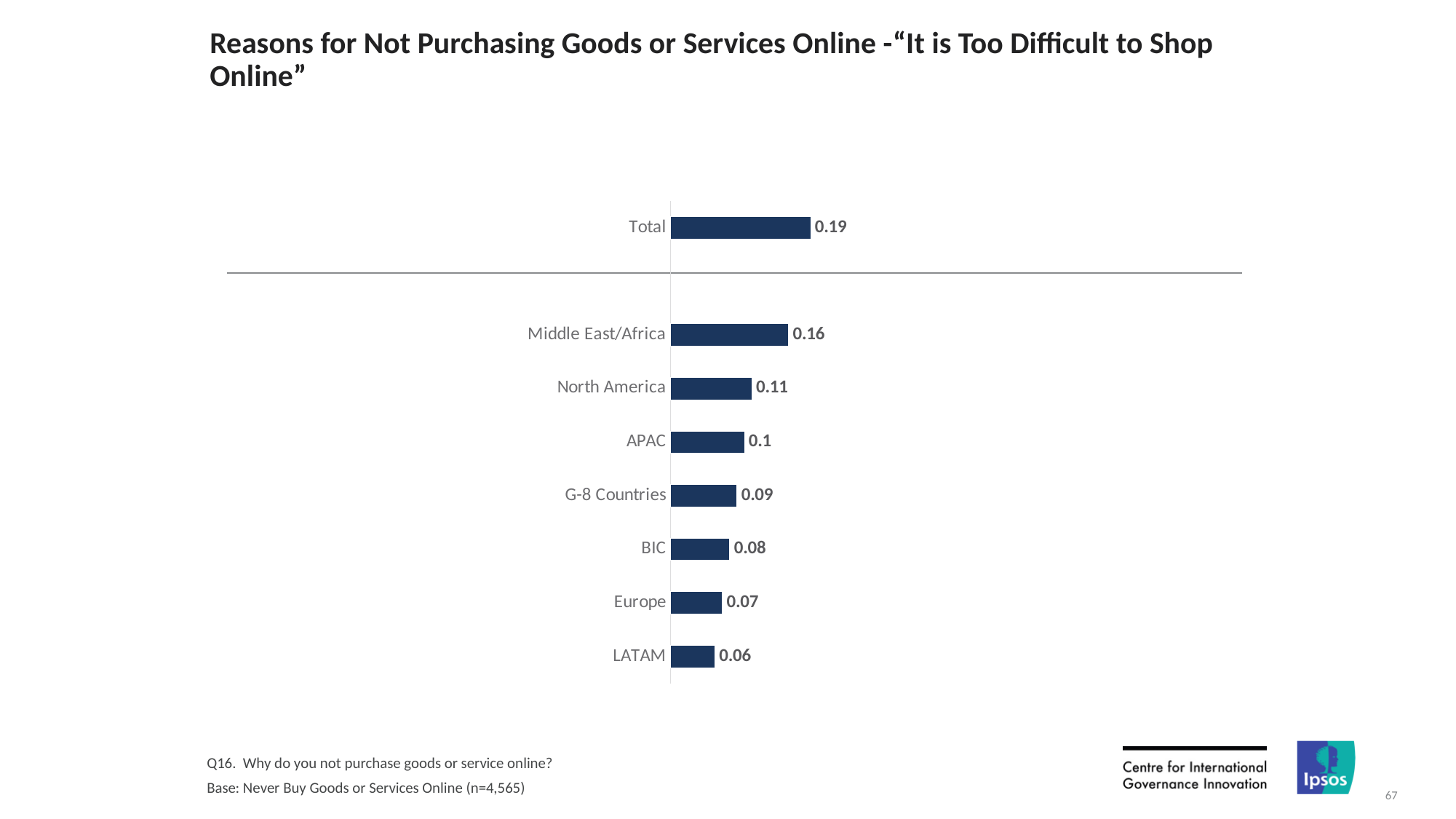
Which category has the lowest value? LATAM What is the difference between the Total value and the value for G-8 Countries? 0.1 What is the base size (n) stated at the bottom of the slide? n=4,565 Which region has the highest value? Middle East/Africa What is the value for Total? 0.19 What is the value for Middle East/Africa? 0.16 What is the value for LATAM? 0.06 How many categories are shown in the chart? 8 Which is larger, the value for APAC or the value for BIC? APAC What kind of chart is shown on the slide? Bar chart What is the value for North America? 0.11 What is the difference between the values for Middle East/Africa and Europe? 0.09